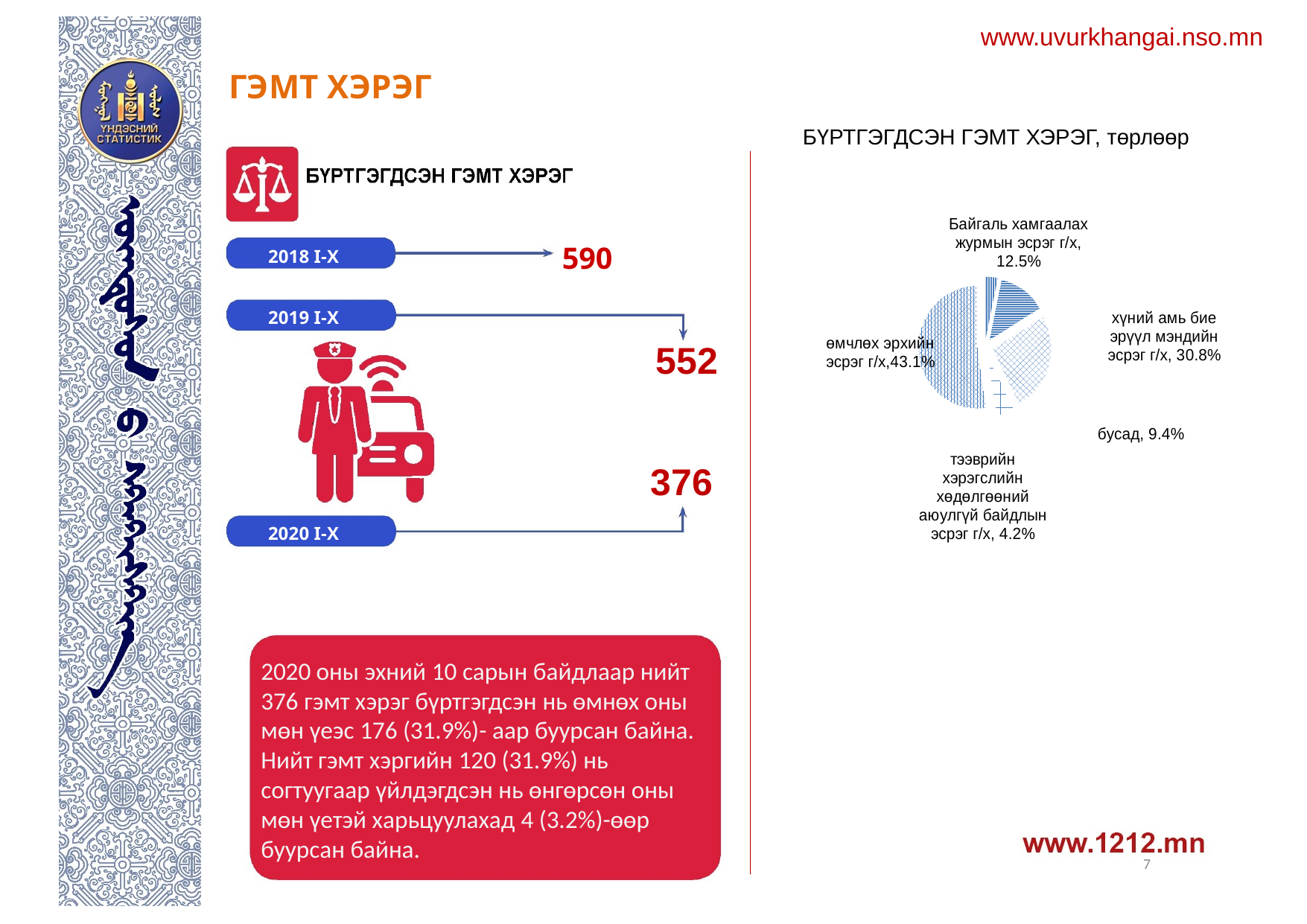
In the pie chart 'БҮРТГЭГДСЭН ГЭМТ ХЭРЭГ, төрлөөр', what share is labelled for 'хүний амь бие эрүүл мэндийн эсрэг г/х'? 30.8% In the pie chart 'БҮРТГЭГДСЭН ГЭМТ ХЭРЭГ, төрлөөр', what share is labelled for 'өмчлөх эрхийн эсрэг г/х'? 43.1% In the pie chart 'БҮРТГЭГДСЭН ГЭМТ ХЭРЭГ, төрлөөр', which category has the largest share? өмчлөх эрхийн эсрэг г/х What type of chart is 'БҮРТГЭГДСЭН ГЭМТ ХЭРЭГ, төрлөөр'? Pie chart In the pie chart 'БҮРТГЭГДСЭН ГЭМТ ХЭРЭГ, төрлөөр', how many slices are there? 5 In the pie chart 'БҮРТГЭГДСЭН ГЭМТ ХЭРЭГ, төрлөөр', what is the difference in percentage points between 'өмчлөх эрхийн эсрэг г/х' and 'хүний амь бие эрүүл мэндийн эсрэг г/х'? 12.3 percentage points In the pie chart 'БҮРТГЭГДСЭН ГЭМТ ХЭРЭГ, төрлөөр', what share is labelled for 'Байгаль хамгаалах журмын эсрэг г/х'? 12.5% In the pie chart 'БҮРТГЭГДСЭН ГЭМТ ХЭРЭГ, төрлөөр', what share is labelled for 'тээврийн хэрэгслийн хөдөлгөөний аюулгүй байдлын эсрэг г/х'? 4.2% In the pie chart 'БҮРТГЭГДСЭН ГЭМТ ХЭРЭГ, төрлөөр', what share is labelled for 'бусад'? 9.4% In the left infographic 'БҮРТГЭГДСЭН ГЭМТ ХЭРЭГ', what is the value for 2019 I-X? 552